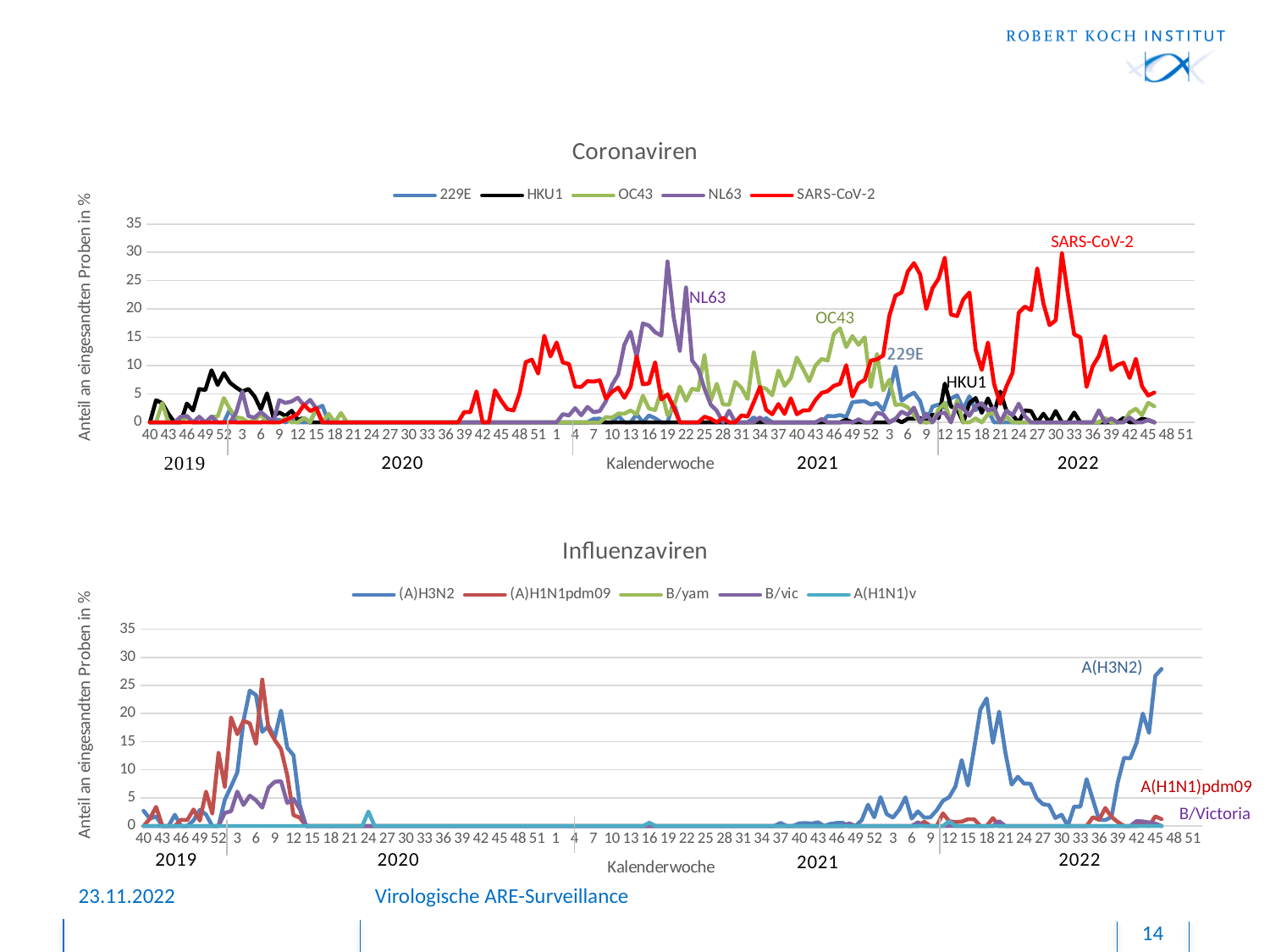
What type of chart is the Coronaviren chart? line chart In the Coronaviren chart, is the peak value of NL63 greater or less than 20? greater In the Coronaviren chart, is the peak value of HKU1 greater or less than 15? less In the Coronaviren chart, is the peak value of SARS-CoV-2 greater or less than 25? greater How many series does the legend of the Coronaviren chart list? 5 What is the y-axis label of the Influenzaviren chart? Anteil an eingesandten Proben in % In the Coronaviren chart, which series has the higher peak, NL63 or HKU1? NL63 How many series does the legend of the Influenzaviren chart list? 5 In the Coronaviren chart, which series reaches the highest value? SARS-CoV-2 In the Influenzaviren chart, does the A(H3N2) line rise or fall over the last weeks of 2022? rise In the Influenzaviren chart, which series reaches the highest value in 2022? A(H3N2)